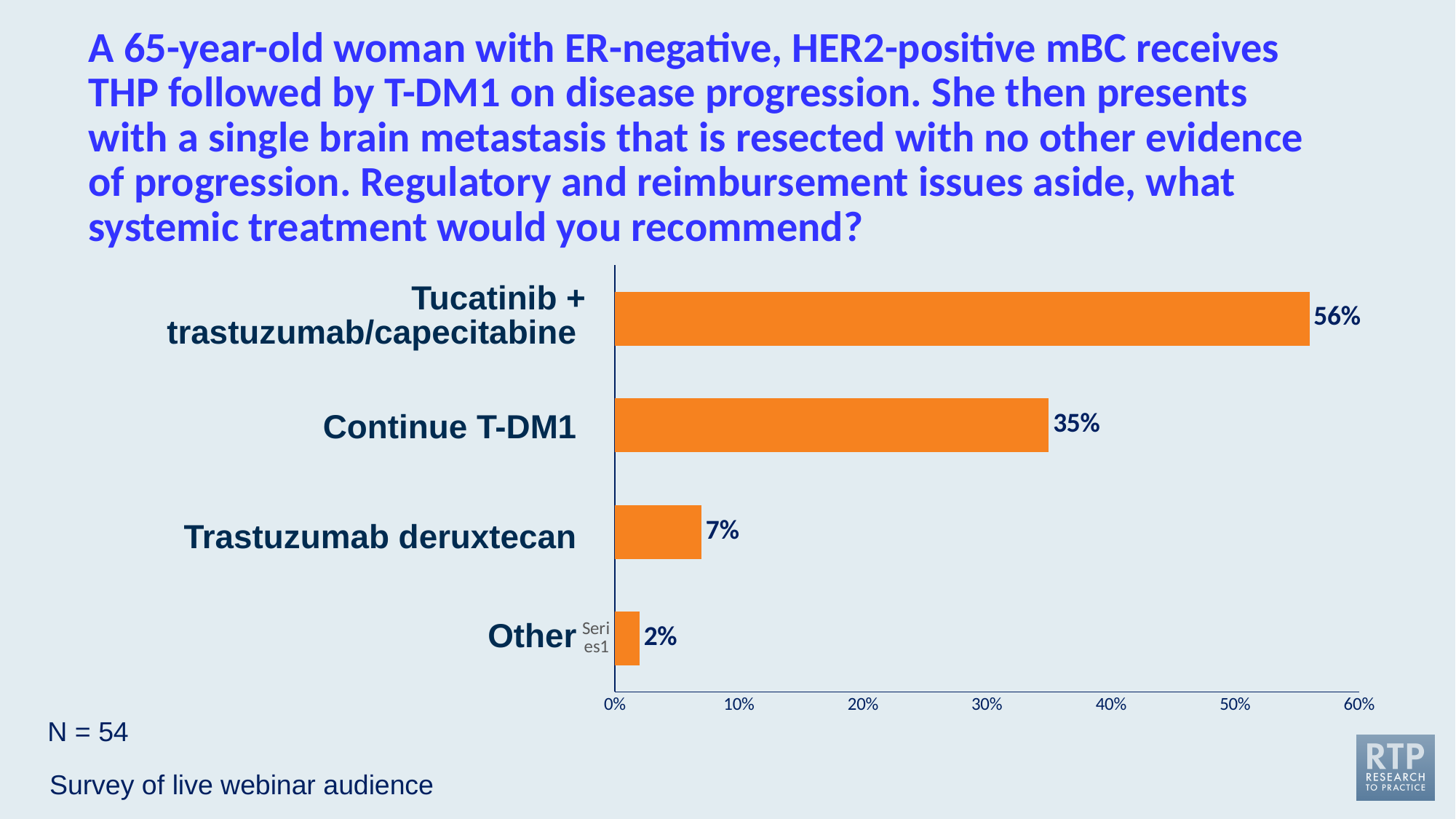
Which received a larger share of responses, Continue T-DM1 or Trastuzumab deruxtecan? Continue T-DM1 What kind of chart is shown on the slide? Bar chart What percentage of respondents chose Tucatinib + trastuzumab/capecitabine? 56% What percentage of respondents chose Continue T-DM1? 35% Which treatment option received the lowest share of responses? Other What percentage of respondents chose Other? 2% What is the N (number of respondents) stated on the slide? 54 Which treatment option received the highest share of responses? Tucatinib + trastuzumab/capecitabine What is the difference in percentage points between Tucatinib + trastuzumab/capecitabine and Continue T-DM1? 21 percentage points How many treatment options are shown in the chart? 4 Is the value for Continue T-DM1 greater or less than 40%? less What percentage of respondents chose Trastuzumab deruxtecan? 7%